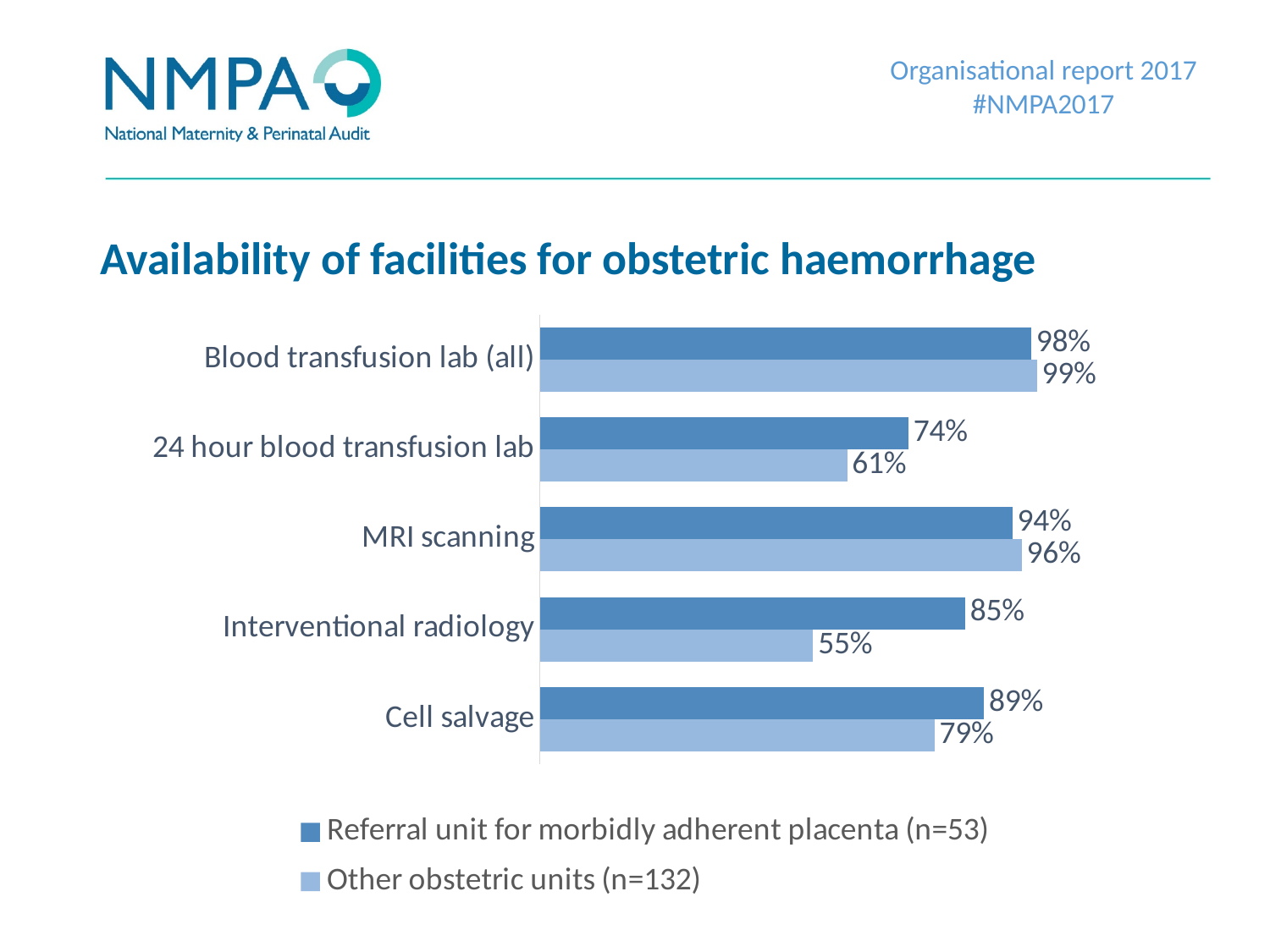
What percentage of referral units for morbidly adherent placenta have interventional radiology available? 85% Which facility has the lowest availability among referral units for morbidly adherent placenta? 24 hour blood transfusion lab What type of chart is shown on the slide? Bar chart What is the difference between referral units and other obstetric units for interventional radiology? 30% How many series does the legend list? 2 What is the title of the chart? Availability of facilities for obstetric haemorrhage Which facility has the highest availability among other obstetric units? Blood transfusion lab (all) How many other obstetric units are included according to the legend? n=132 For MRI scanning, which group has the higher value: referral units for morbidly adherent placenta or other obstetric units? Other obstetric units What is the value for cell salvage among other obstetric units? 79% What percentage of other obstetric units have a 24 hour blood transfusion lab? 61% How many facility categories are shown in the chart? 5